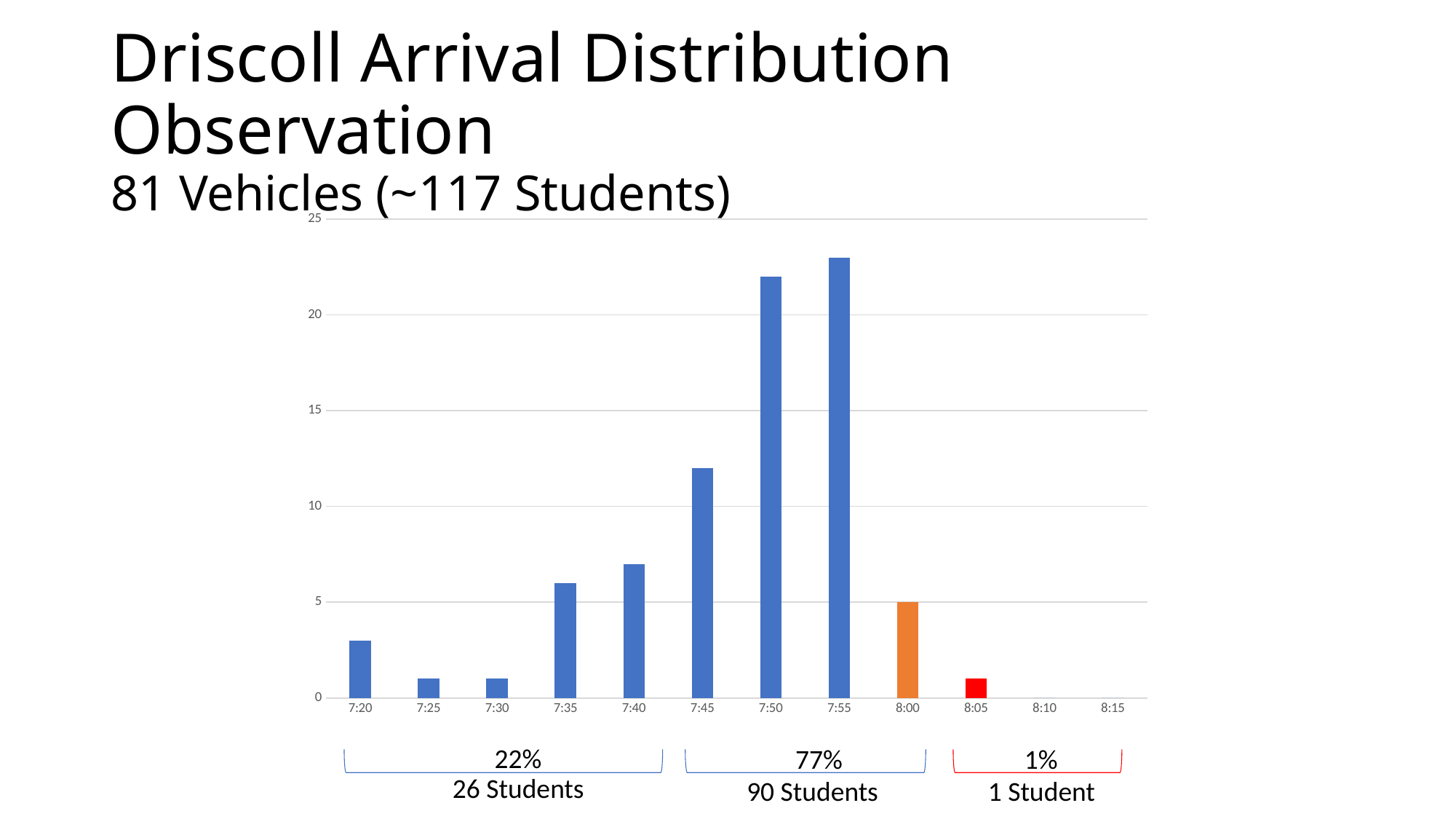
Which time has the highest bar in the chart? 7:55 According to the annotation below the chart, what percentage of students arrived between 7:45 and 8:00? 77% How many time categories are shown on the x axis of the chart? 12 Is the value for 7:40 greater or less than 10? less According to the annotation below the chart, how many students arrived in the 7:20 to 7:40 group? 26 Students Is the value for 7:20 greater or less than 5? less What is the value for 8:00 in the chart? 5 Is the value for 7:45 greater or less than 10? greater What kind of chart is shown on the slide? bar chart Which is larger, the value for 7:45 or the value for 7:50? 7:50 Which is larger, the value for 7:35 or the value for 7:25? 7:35